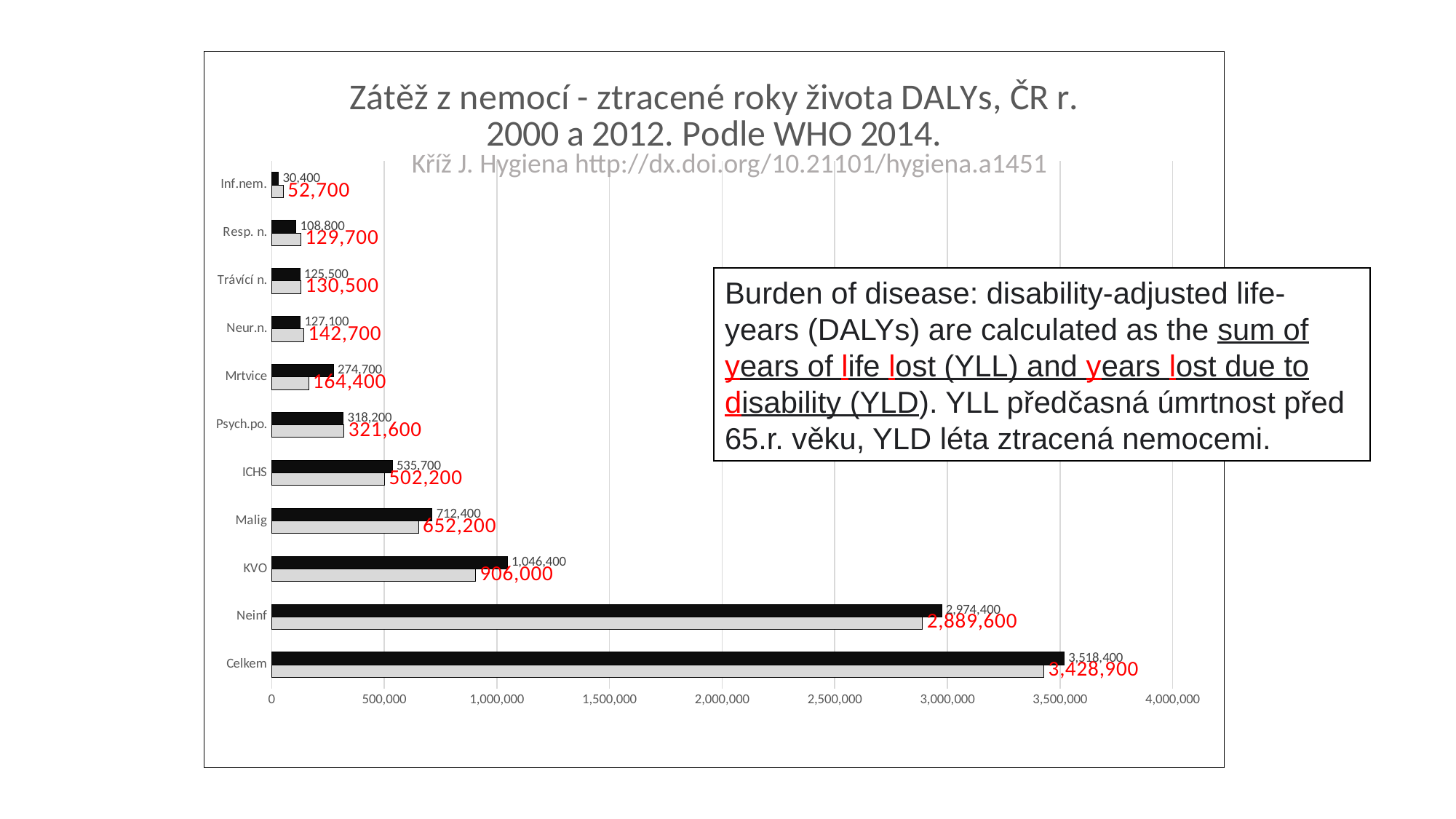
How many categories are plotted on the chart? 11 What kind of chart is shown on the slide? bar chart What is the title of the chart? Zátěž z nemocí - ztracené roky života DALYs, ČR r. 2000 a 2012. Podle WHO 2014. What is the value labelled on the black bar for Neinf? 2,974,400 Which category has the lowest value among the grey bars? Inf.nem. What is the value labelled on the black bar for Mrtvice? 274,700 For Mrtvice, which is larger: the black bar value or the grey bar value? the black bar value What is the value shown in red for the grey bar of Celkem? 3,428,900 What is the value shown in red for the grey bar of KVO? 906,000 Which category has the highest value among the black bars? Celkem Is the grey bar value for Malig greater or less than 1,000,000? less What is the difference between the black bar value and the grey bar value for KVO? 140,400